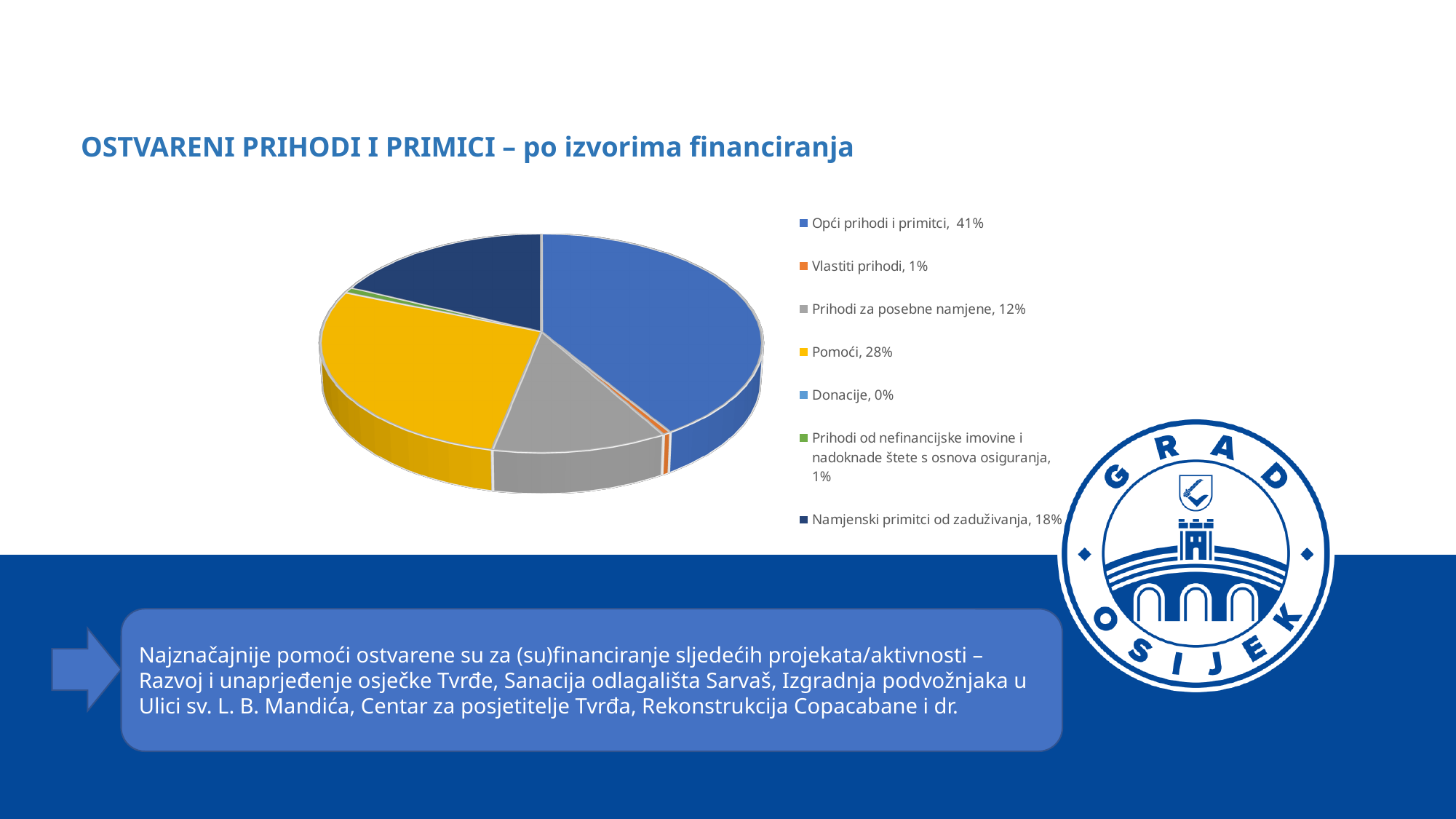
What colour is the slice for "Pomoći"? Yellow Which category has the smallest share of the pie? Donacije What share of the pie does "Prihodi za posebne namjene" represent? 12% What share of the pie does "Pomoći" represent? 28% What kind of chart is shown on the slide? Pie chart What is the difference in percentage points between "Opći prihodi i primitci" and "Pomoći"? 13 Which is larger, the share for "Namjenski primitci od zaduživanja" or the share for "Prihodi za posebne namjene"? Namjenski primitci od zaduživanja What share of the pie does "Namjenski primitci od zaduživanja" represent? 18% What is the title of the chart slide? OSTVARENI PRIHODI I PRIMICI – po izvorima financiranja How many categories does the pie chart show? 7 Which category has the largest share of the pie? Opći prihodi i primitci